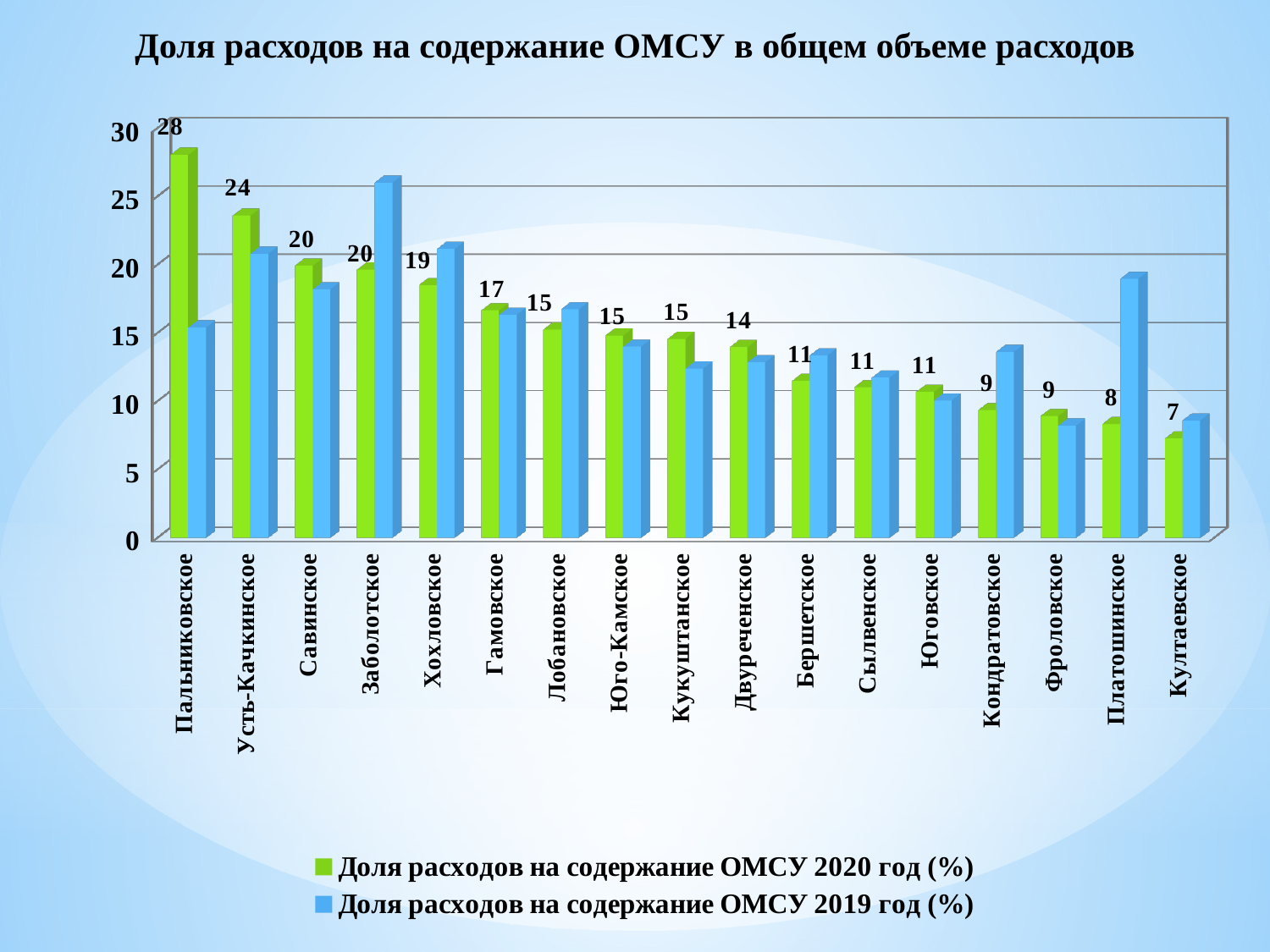
Do the 2020 values rise or fall from left to right along the x axis? fall What kind of chart is shown on the slide? bar chart How many series does the legend list? 2 What is the 2020 value (Доля расходов на содержание ОМСУ 2020 год) for Пальниковское? 28 Which is larger for Заболотское: the 2020 value or the 2019 value? 2019 What is the 2020 value for Усть-Качкинское? 24 Which category has the highest 2020 value? Пальниковское What is the difference between the 2020 values for Пальниковское and Усть-Качкинское? 4 Is the 2019 value for Платошинское greater or less than 15? greater Which category has the lowest 2020 value? Култаевское How many categories are shown on the x axis? 17 What is the 2020 value for Култаевское? 7